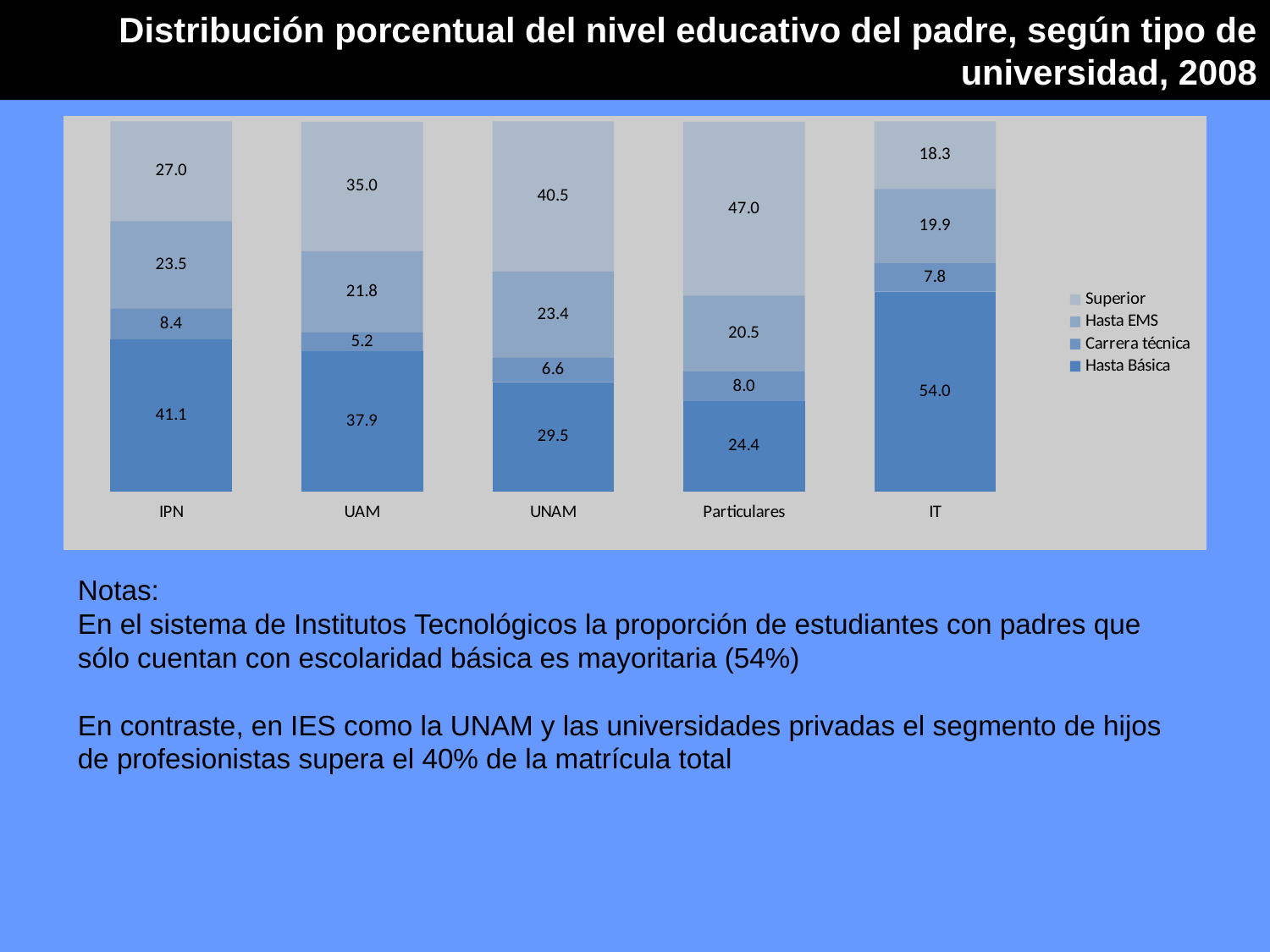
What is the value for Hasta Básica at IT? 54.0 What kind of chart is shown? Stacked bar chart What is the value for Carrera técnica at UAM? 5.2 How many series does the legend list? 4 How many categories are shown on the x axis? 5 What is the value for Superior at Particulares? 47.0 What is the difference between the Hasta Básica values for IT and IPN? 12.9 What is the value for Hasta EMS at UNAM? 23.4 Which category has the highest value for Superior? Particulares What is the total of the stacked bar for UNAM? 100.0 Which category has the lowest value for Hasta Básica? Particulares Which is larger, the Superior value for UNAM or for UAM? UNAM